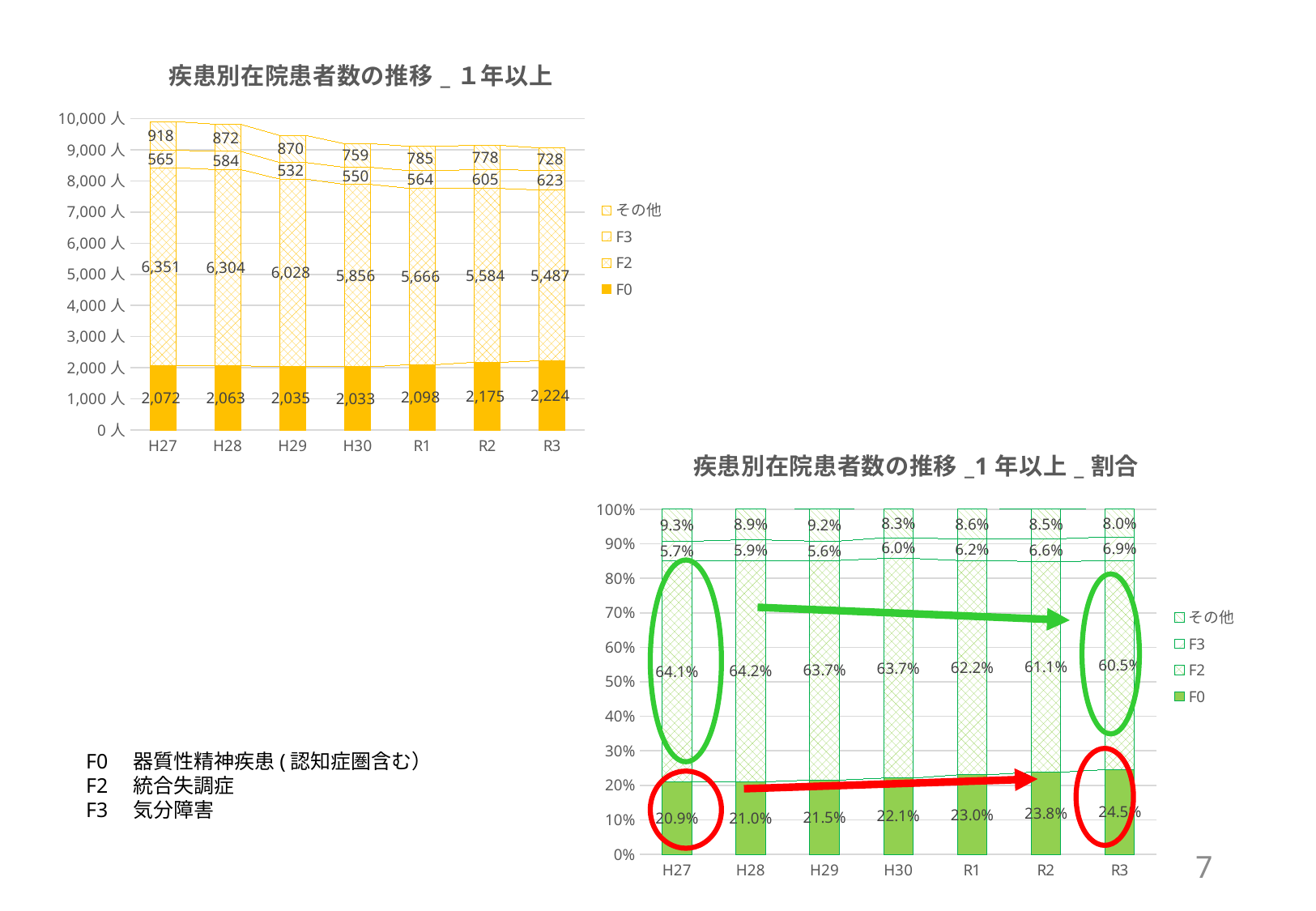
In the chart titled 疾患別在院患者数の推移 _ １年以上, which year has the lowest F0 value? H30 In the chart titled 疾患別在院患者数の推移 _ １年以上, what is the total of the stacked bar for R3? 9,062 In the chart titled 疾患別在院患者数の推移 _1 年以上 _ 割合, how many years are shown on the x axis? 7 In the chart titled 疾患別在院患者数の推移 _ １年以上, how many series does the legend list? 4 In the chart titled 疾患別在院患者数の推移 _ １年以上, what is the F2 value for R3? 5,487 In the chart titled 疾患別在院患者数の推移 _1 年以上 _ 割合, what is the F0 share for R3? 24.5% In the chart titled 疾患別在院患者数の推移 _1 年以上 _ 割合, which year has the lowest F2 share? R3 In the chart titled 疾患別在院患者数の推移 _ １年以上, which year has the highest F2 value? H27 In the chart titled 疾患別在院患者数の推移 _1 年以上 _ 割合, which is larger: the その他 share for H27 or for R3? H27 In the chart titled 疾患別在院患者数の推移 _ １年以上, what is the F0 value for H27? 2,072 In the chart titled 疾患別在院患者数の推移 _ １年以上, what is the difference between the F2 values for H27 and R3? 864 In the chart titled 疾患別在院患者数の推移 _ １年以上, does the F2 value rise or fall from H27 to R3? fall